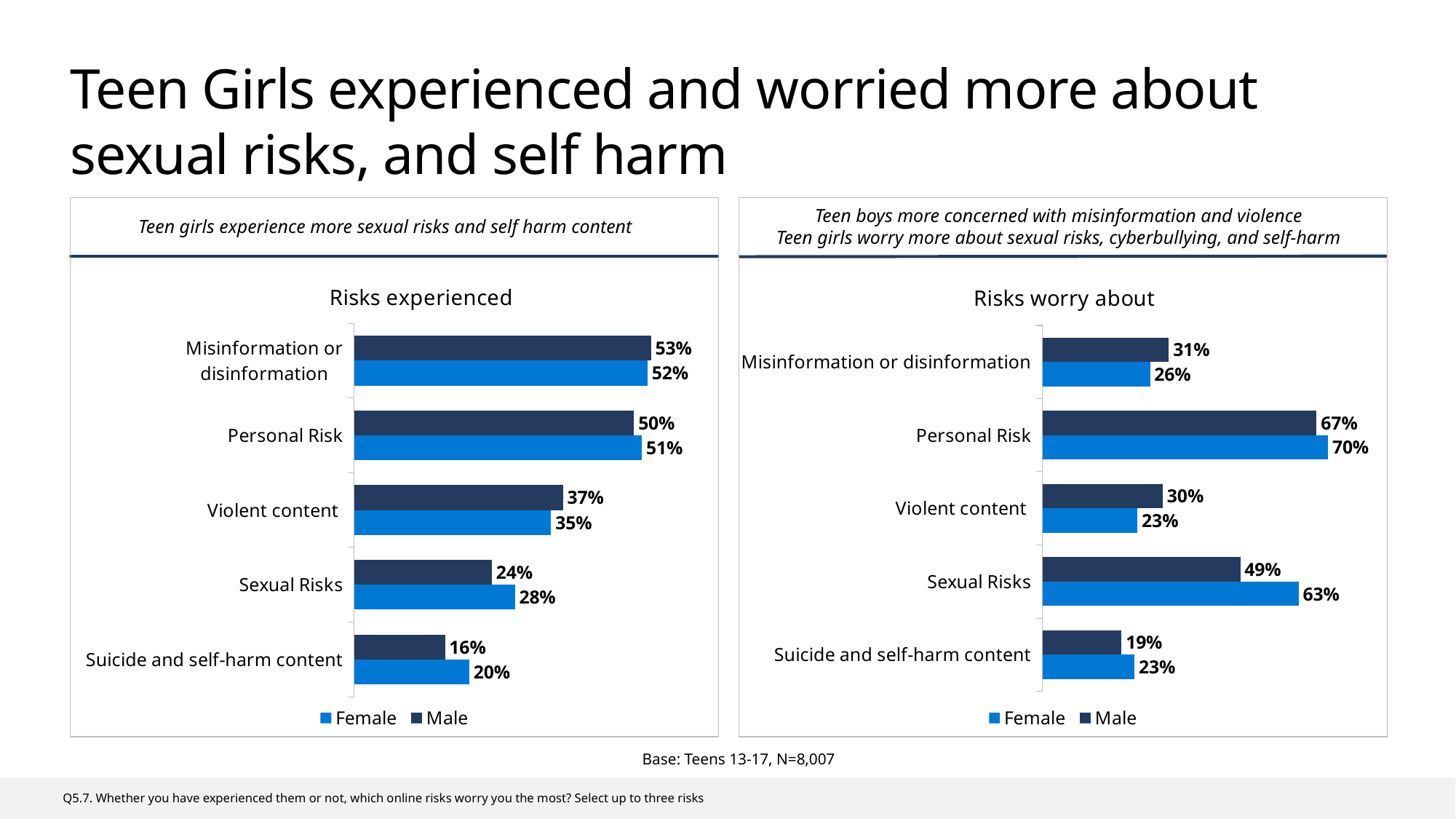
In the 'Risks worry about' chart, is the Female or Male value larger for Violent content? Male In the 'Risks worry about' chart, which category has the highest Female value? Personal Risk How many categories are shown in the 'Risks experienced' chart? 5 What type of chart is the 'Risks experienced' chart? Bar chart In the 'Risks experienced' chart, which category has the lowest Male value? Suicide and self-harm content In the 'Risks worry about' chart, what is the Female value for Personal Risk? 70% In the 'Risks worry about' chart, what is the difference between the Female and Male values for Sexual Risks? 14% In the 'Risks experienced' chart, what is the Female value for Sexual Risks? 28% In the 'Risks worry about' chart, what is the Male value for Misinformation or disinformation? 31% How many series does the legend of the 'Risks worry about' chart list? 2 In the 'Risks experienced' chart, is the Female or Male value larger for Suicide and self-harm content? Female In the 'Risks experienced' chart, what is the difference between the Male and Female values for Violent content? 2%